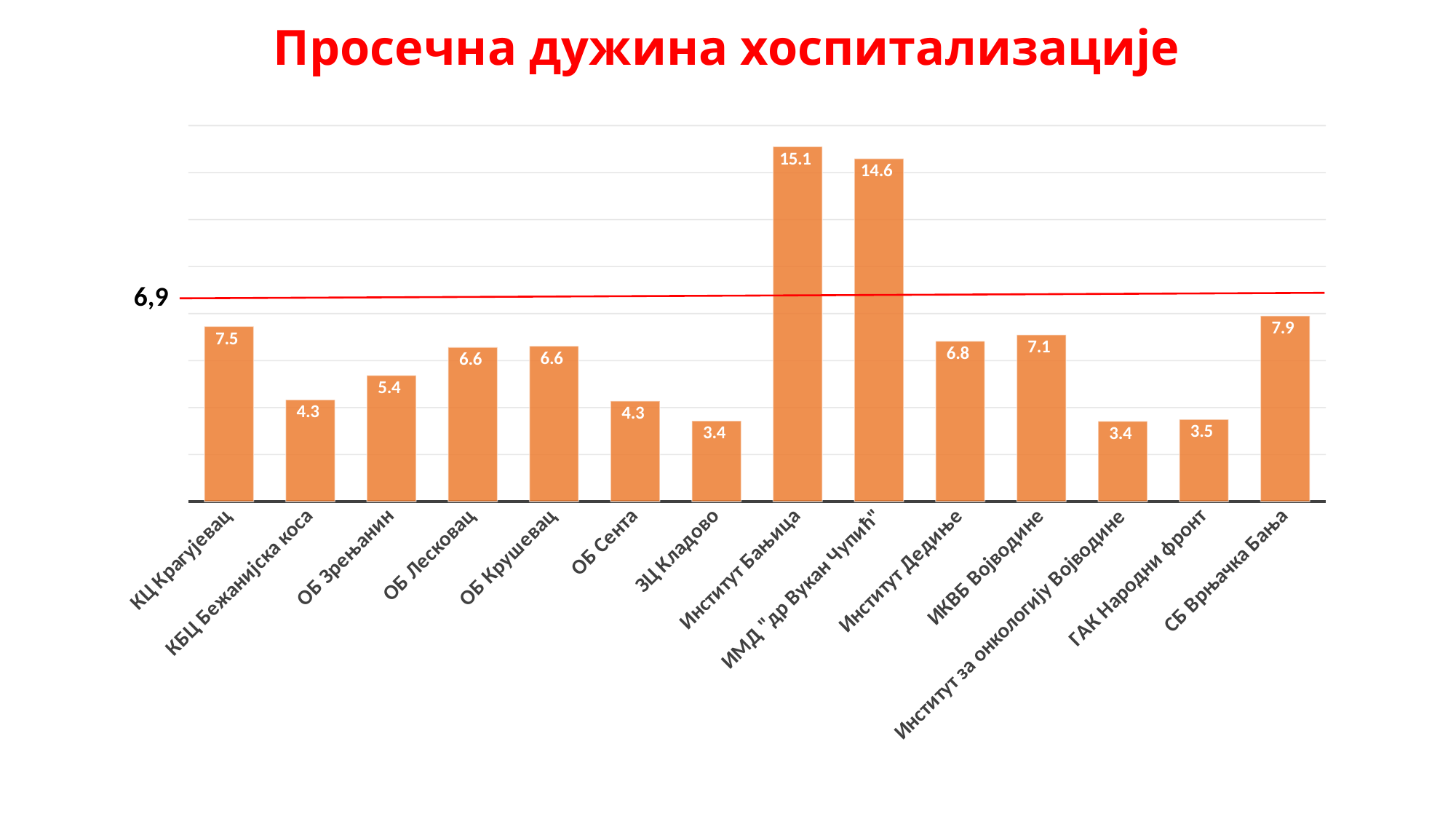
How many categories (institutions) are shown in the chart? 14 Which is larger, the value for КЦ Крагујевац or the value for ИКВБ Војводине? КЦ Крагујевац What type of chart is shown on the slide? bar chart What is the difference between the values for Институт Бањица and ИМД "др Вукан Чупић"? 0.5 What is the title of the chart? Просечна дужина хоспитализације What is the value for ОБ Зрењанин? 5.4 What is the lowest value shown in the chart? 3.4 What is the value for ИМД "др Вукан Чупић"? 14.6 Which institution has the highest value in the chart? Институт Бањица What is the value for СБ Врњачка Бања? 7.9 What is the value for Институт Бањица? 15.1 What value is marked by the red horizontal line on the chart? 6,9